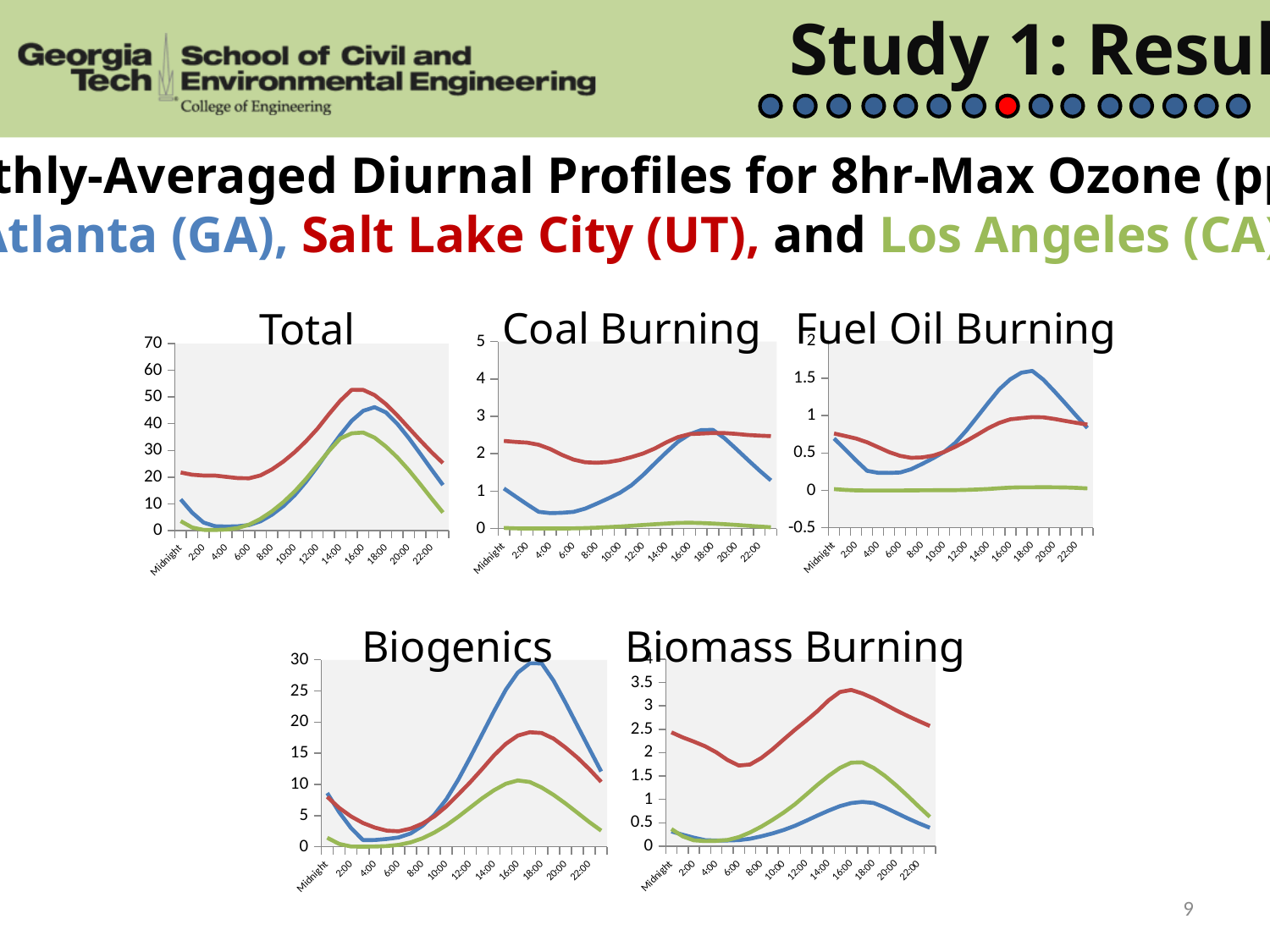
What kind of chart is the 'Total' chart? line chart In the 'Biogenics' chart, is the peak value of the blue (Atlanta) line greater or less than 25? greater In the 'Total' chart, which line is higher at 16:00, the red (Salt Lake City) line or the blue (Atlanta) line? red (Salt Lake City) In the 'Total' chart, is the peak value of the green (Los Angeles) line greater or less than 40? less How many charts are shown on the slide? 5 In the 'Coal Burning' chart, is the value of the red (Salt Lake City) line at Midnight greater or less than 2? greater In the 'Total' chart, does the blue (Atlanta) line rise or fall between 4:00 and 16:00? rise What is the highest value shown on the y-axis of the 'Total' chart? 70 In the 'Biogenics' chart, which line reaches the highest peak? blue (Atlanta)